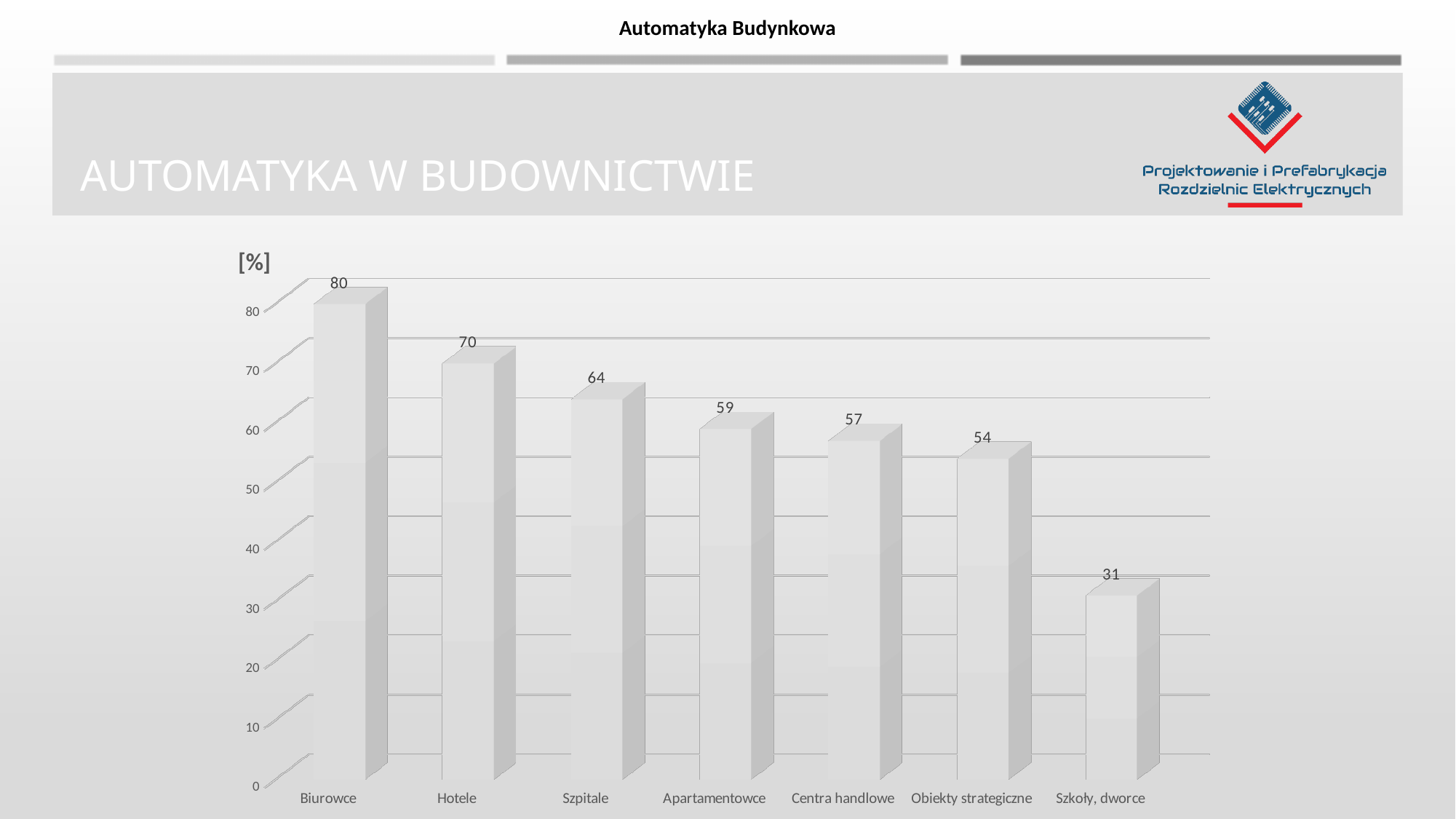
How many categories are shown on the x axis? 7 What kind of chart is shown on the slide? bar chart Which category has the lowest value? Szkoły, dworce What is the value for Biurowce? 80 What is the value for Szpitale? 64 What is the difference between the values for Hotele and Apartamentowce? 11 Is the value for Obiekty strategiczne greater or less than 50? greater What unit is shown on the vertical axis label? [%] What is the value for Szkoły, dworce? 31 Which category has the highest value? Biurowce Do the values rise or fall from left to right along the x axis? fall Which is larger, the value for Centra handlowe or the value for Obiekty strategiczne? Centra handlowe